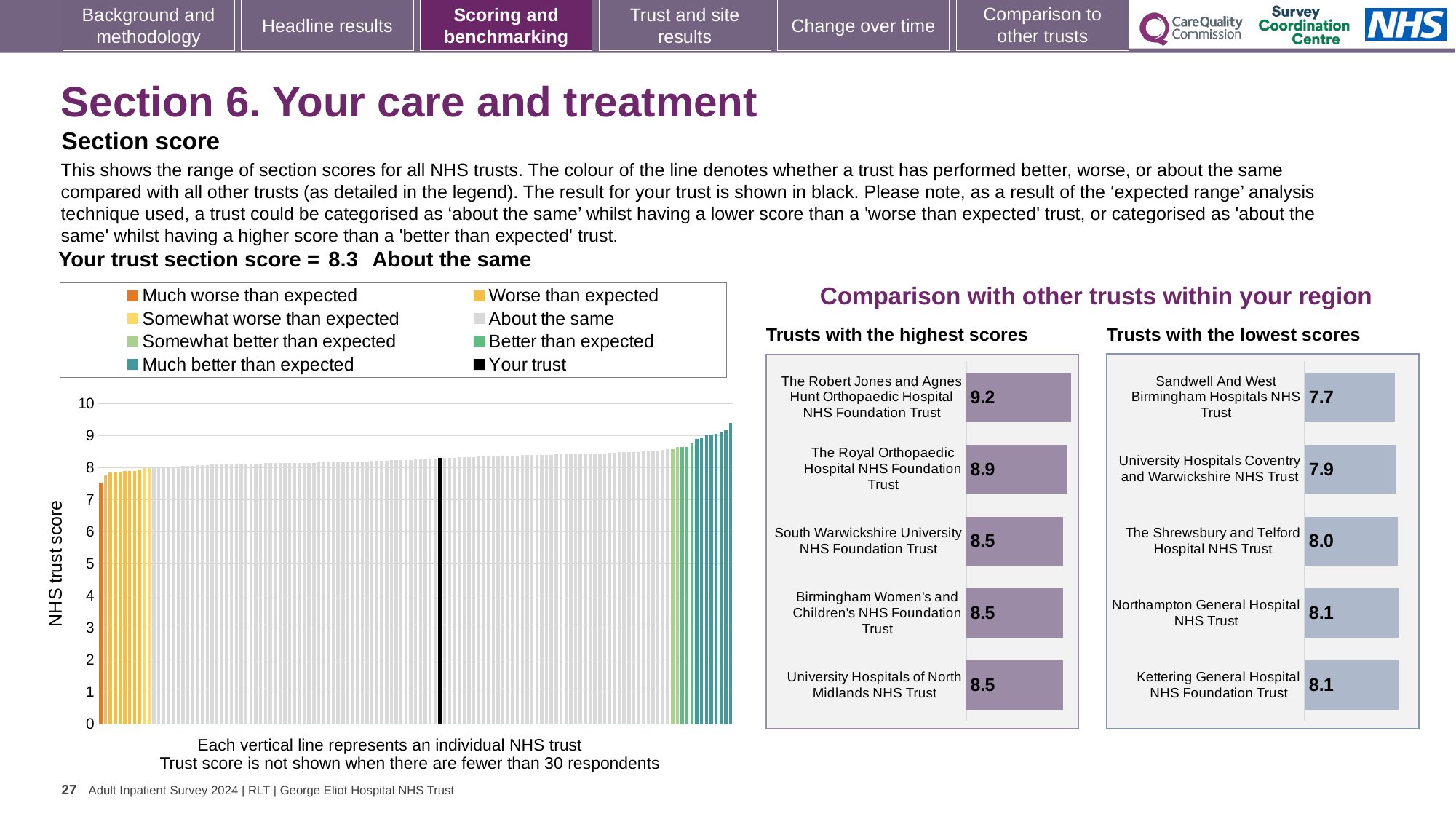
How many trusts are shown in the 'Trusts with the highest scores' chart? 5 What kind of chart is the large chart on the left showing NHS trust scores? Bar chart In the 'Trusts with the highest scores' chart, which trust has the highest score? The Robert Jones and Agnes Hunt Orthopaedic Hospital NHS Foundation Trust In the 'Trusts with the lowest scores' chart, what is the score for Sandwell And West Birmingham Hospitals NHS Trust? 7.7 What is the title of the comparison section on the right of the slide? Comparison with other trusts within your region How many entries does the legend of the large chart on the left list? 8 According to the slide, what is your trust's section score for Section 6? 8.3 In the 'Trusts with the lowest scores' chart, which has the higher score: University Hospitals Coventry and Warwickshire NHS Trust or The Shrewsbury and Telford Hospital NHS Trust? The Shrewsbury and Telford Hospital NHS Trust In the 'Trusts with the highest scores' chart, what is the score for The Robert Jones and Agnes Hunt Orthopaedic Hospital NHS Foundation Trust? 9.2 In the 'Trusts with the lowest scores' chart, what is the difference between the scores of The Shrewsbury and Telford Hospital NHS Trust and Sandwell And West Birmingham Hospitals NHS Trust? 0.3 In the 'Trusts with the lowest scores' chart, which trust has the lowest score? Sandwell And West Birmingham Hospitals NHS Trust In the 'Trusts with the highest scores' chart, what is the difference between the scores of The Robert Jones and Agnes Hunt Orthopaedic Hospital NHS Foundation Trust and The Royal Orthopaedic Hospital NHS Foundation Trust? 0.3